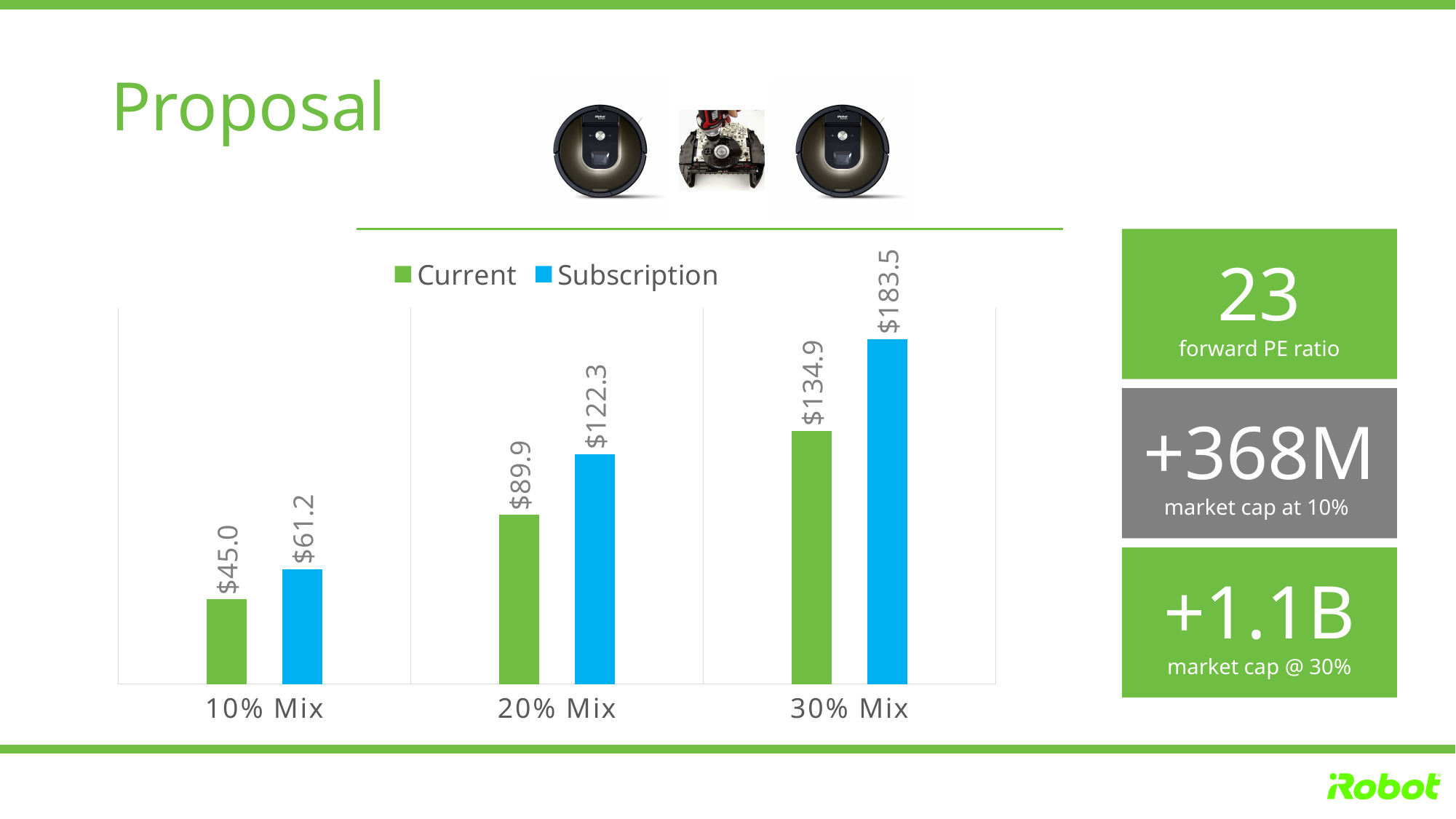
What kind of chart is shown on the slide? Bar chart How many series does the legend list? 2 What is the Subscription value for 20% Mix? $122.3 How many categories are shown on the x axis? 3 What is the Current value for 20% Mix? $89.9 Which category has the lowest Current value? 10% Mix What is the difference between the Subscription and Current values for 10% Mix? $16.2 Which category has the highest Subscription value? 30% Mix What is the Subscription value for 30% Mix? $183.5 What is the Current value for 10% Mix? $45.0 What is the difference between the Subscription and Current values for 30% Mix? $48.6 Which is larger for 20% Mix, the Current value or the Subscription value? Subscription